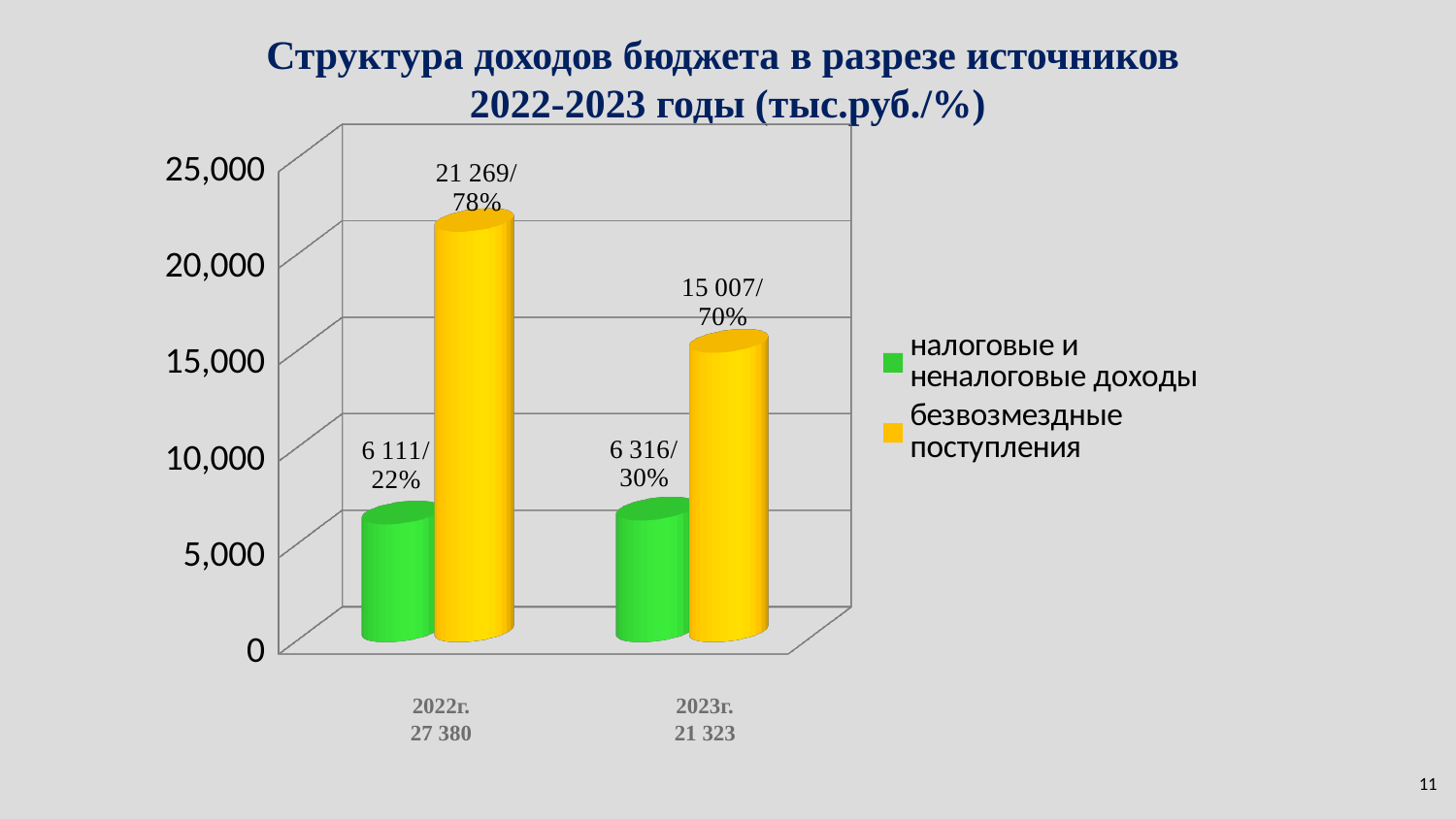
What is the value of налоговые и неналоговые доходы for 2022г.? 6 111/ 22% What is the value of безвозмездные поступления for 2023г.? 15 007/ 70% What is the value of налоговые и неналоговые доходы for 2023г.? 6 316/ 30% Which is larger in 2023г.: налоговые и неналоговые доходы or безвозмездные поступления? безвозмездные поступления What colour represents безвозмездные поступления in the chart? yellow What is the value of безвозмездные поступления for 2022г.? 21 269/ 78% What kind of chart is shown on the slide? bar chart What is the difference between безвозмездные поступления in 2022г. and 2023г. (in тыс.руб.)? 6 262 How many series does the legend list? 2 Which year has the higher value for безвозмездные поступления? 2022г. Is the value for безвозмездные поступления in 2023г. greater or less than 20,000? less Which bar is the lowest on the chart? налоговые и неналоговые доходы for 2022г.